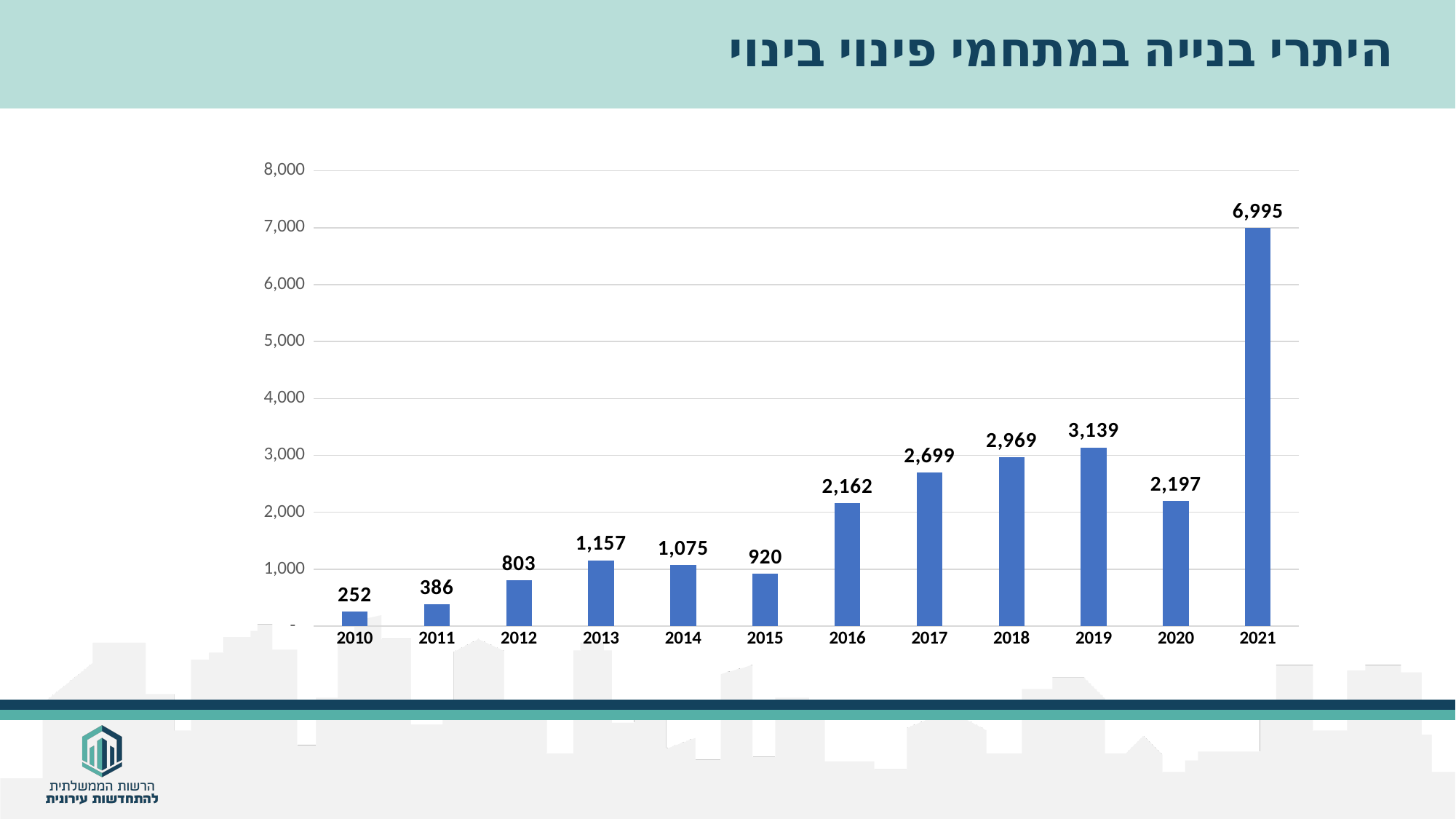
Do the values generally rise or fall from 2010 to 2021? rise Which year has the highest value? 2021 Which is larger, the value for 2014 or the value for 2015? 2014 Which year has the lowest value? 2010 What is the difference between the values for 2013 and 2012? 354 What kind of chart is shown on the slide? bar chart What is the value for 2020? 2,197 Is the value for 2018 greater or less than 3,000? less What is the difference between the values for 2021 and 2019? 3,856 What is the value for 2010? 252 What is the value for 2016? 2,162 How many years are shown on the x axis? 12